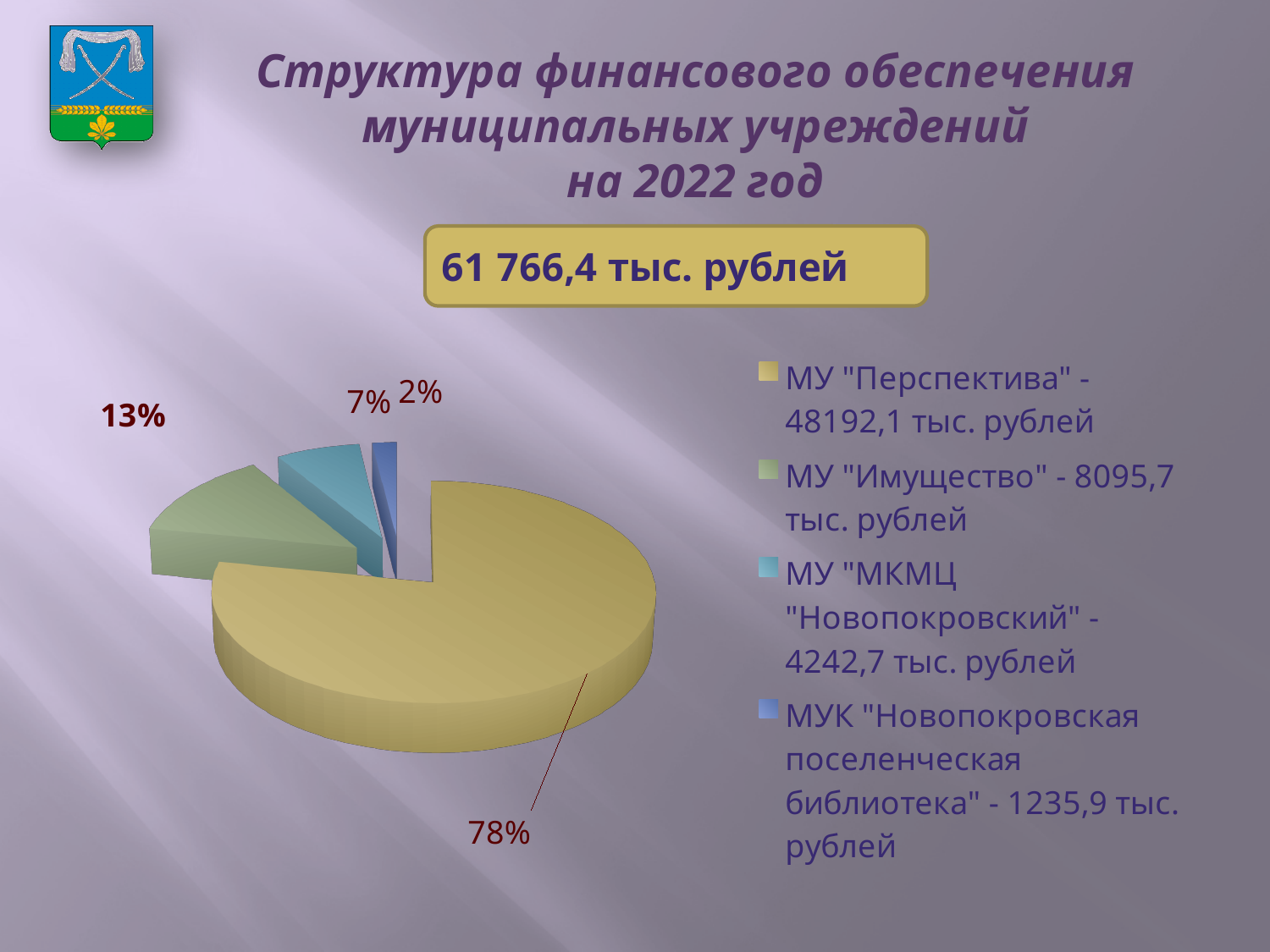
What share of the pie does МУ "МКМЦ "Новопокровский" account for? 7% What is the difference in percentage points between the МУ "Перспектива" slice and the МУ "Имущество" slice? 65 percentage points How many entries does the legend of the pie chart list? 4 What share of the pie does МУК "Новопокровская поселенческая библиотека" account for? 2% Which institution has the smallest slice of the pie chart? МУК "Новопокровская поселенческая библиотека" What share of the pie does МУ "Перспектива" account for? 78% What amount in тыс. рублей does the legend give for МУ "Имущество"? 8095,7 тыс. рублей Which institution has the largest slice of the pie chart? МУ "Перспектива" How many slices does the pie chart have? 4 What kind of chart is shown on the slide? pie chart Which slice is larger: МУ "Имущество" or МУ "МКМЦ "Новопокровский"? МУ "Имущество"